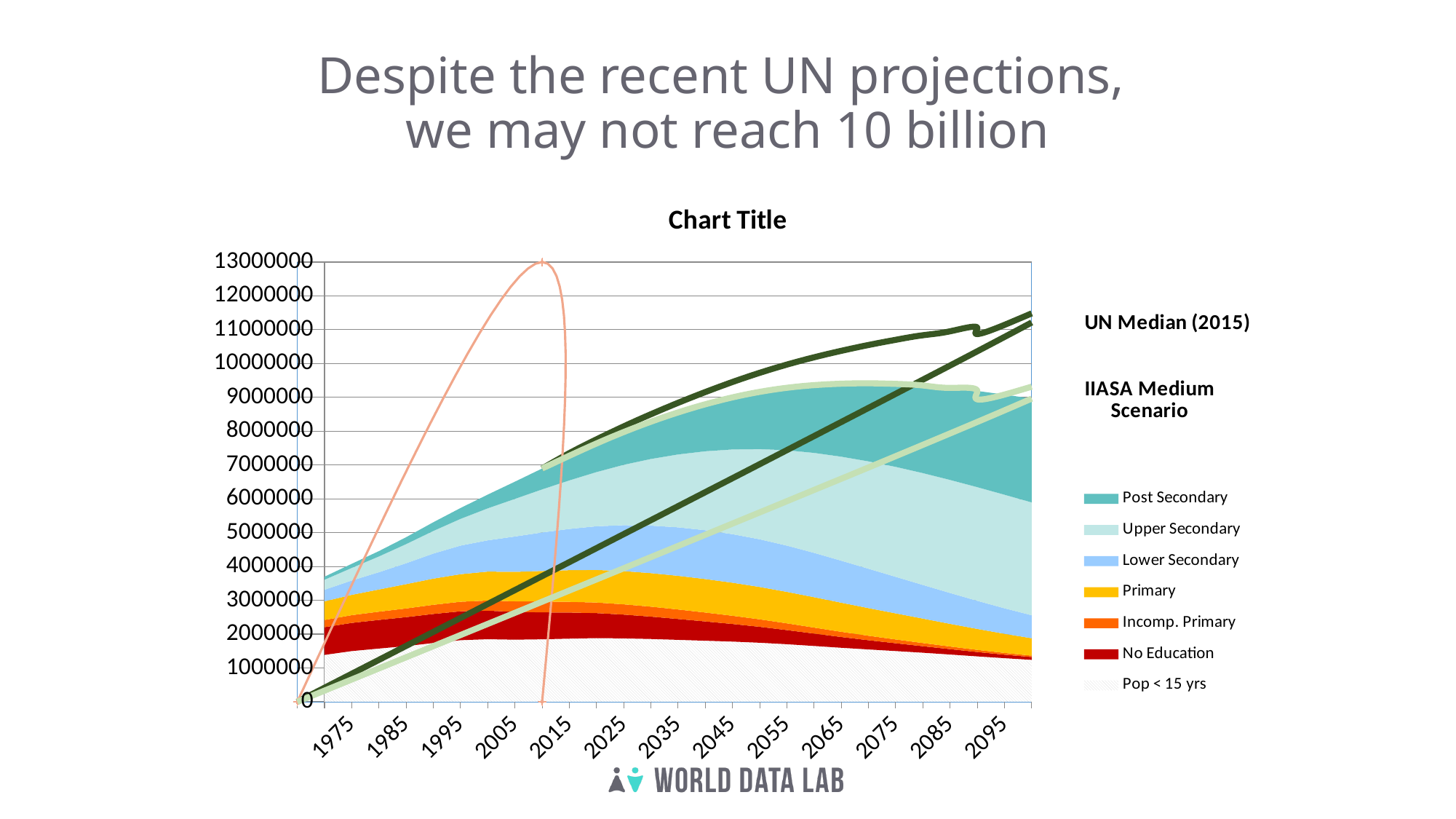
What is the title printed above the chart? Chart Title Does the Post Secondary band get wider or narrower from 1975 to 2095? Wider Which legend entry is shown in red? No Education How many year labels are shown on the x axis? 13 How many entries does the chart legend list? 7 Which line is higher in 2095, UN Median (2015) or IIASA Medium Scenario? UN Median (2015) Is the total of the stacked areas in 1975 greater or less than 5000000? less What kind of chart is shown on the slide? Stacked area chart Is the UN Median (2015) line in 2095 greater or less than 10000000? greater Does the UN Median (2015) line rise or fall from 1975 to 2095? Rises Is the total of the stacked areas in 2055 greater or less than 8000000? greater